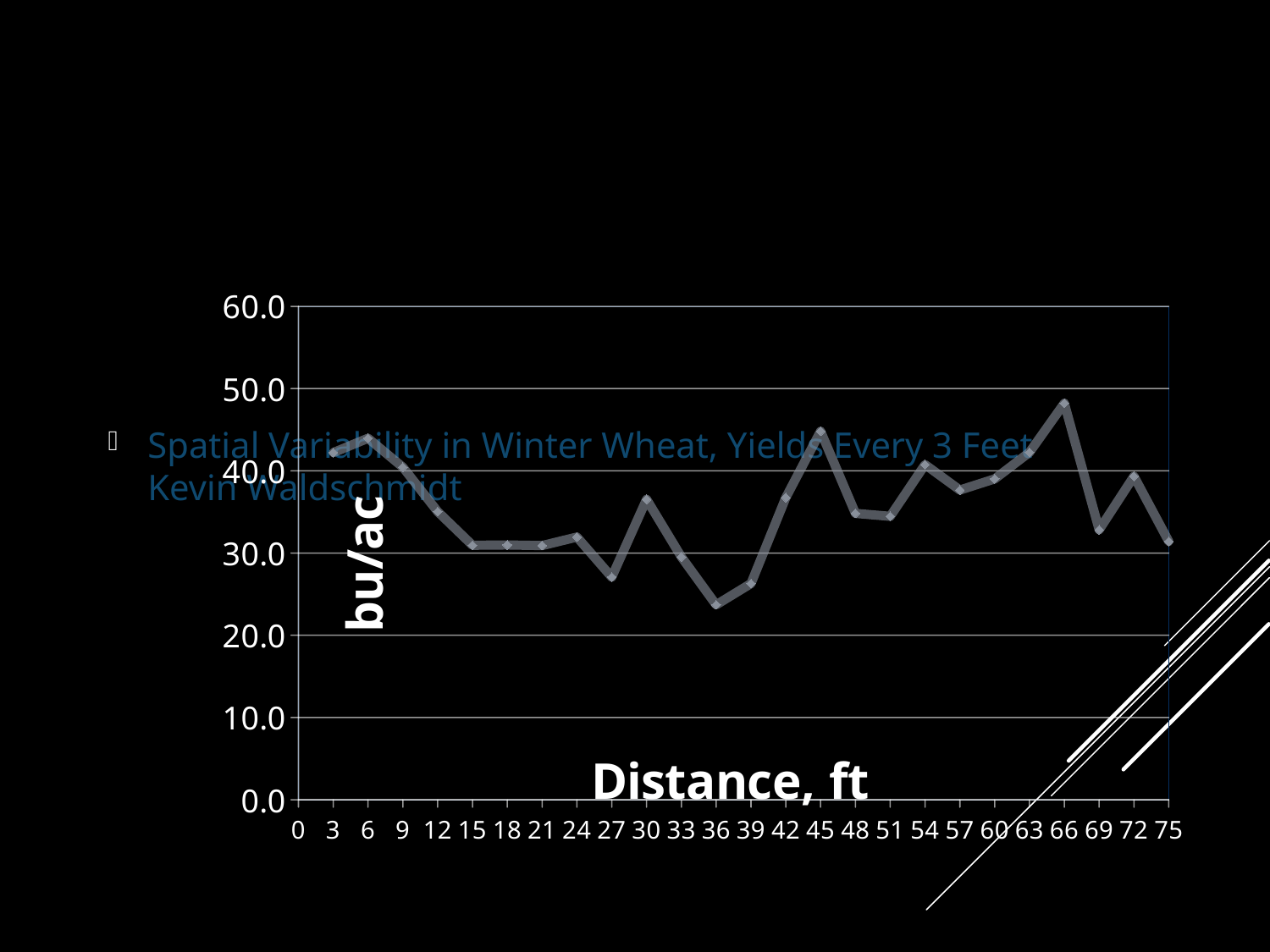
How many data points are plotted on the line? 25 From 12 ft to 15 ft, does the yield rise or fall? fall What kind of chart is shown on the slide? line chart What is the title of the y axis of the chart? bu/ac What is the title of the x axis of the chart? Distance, ft Which has the larger yield, 45 ft or 48 ft? 45 ft Is the value at 12 ft greater or less than 40.0? less Is the value at 45 ft greater or less than 40.0? greater Is the value at 36 ft greater or less than 30.0? less At which distance is the yield lowest? 36 At which distance is the yield highest? 66